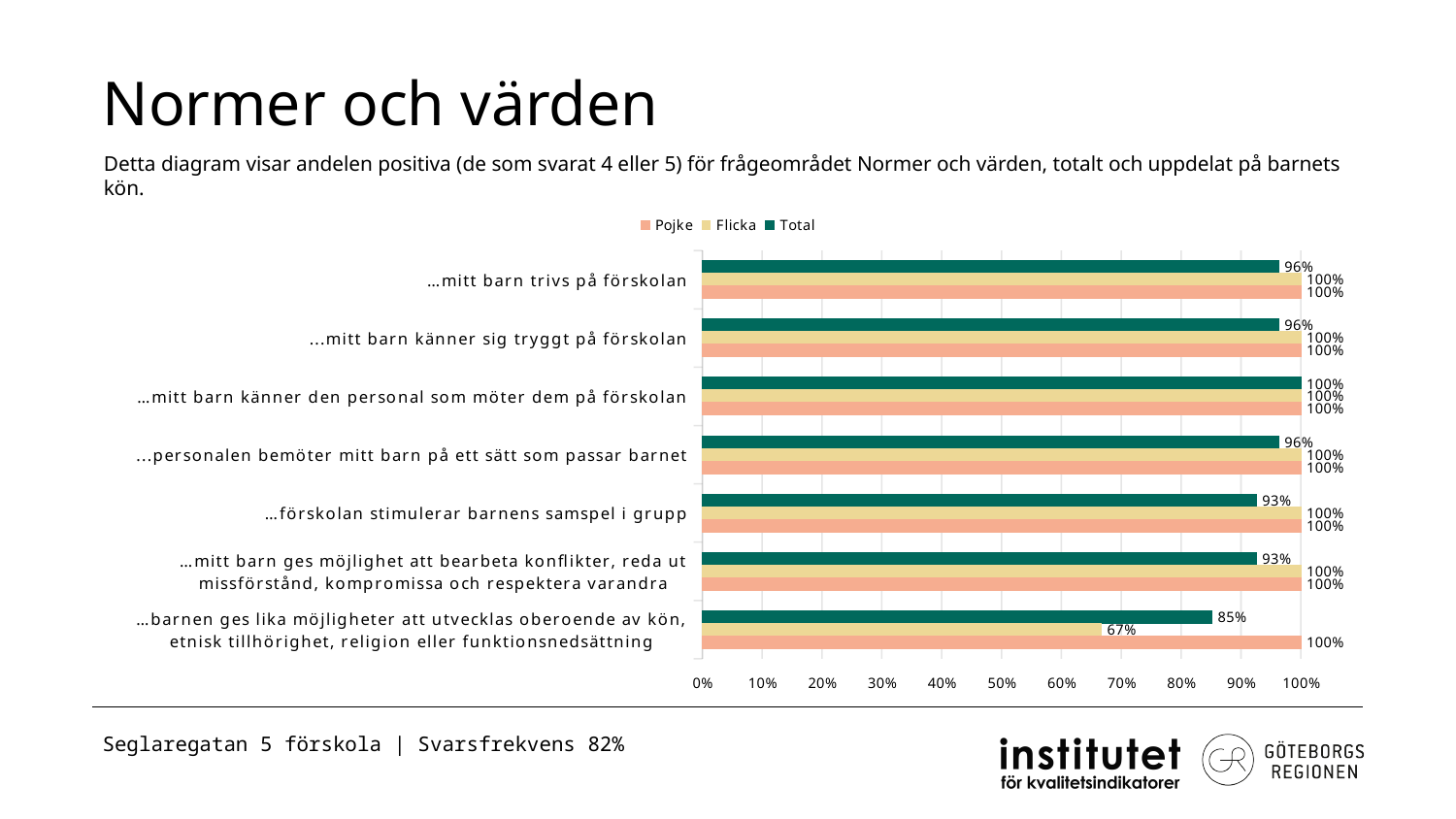
What type of chart is shown on the slide? bar chart How many series does the legend list? 3 What is the Total value for "…förskolan stimulerar barnens samspel i grupp"? 93% What is the Total value for "…mitt barn trivs på förskolan"? 96% Which statement has the lowest Flicka value? …barnen ges lika möjligheter att utvecklas oberoende av kön, etnisk tillhörighet, religion eller funktionsnedsättning For "…mitt barn känner sig tryggt på förskolan", which is larger: the Total value or the Flicka value? Flicka Which series is shown in green in the legend? Total What is the difference between the Pojke and Flicka values for "…barnen ges lika möjligheter att utvecklas oberoende av kön, etnisk tillhörighet, religion eller funktionsnedsättning"? 33% What is the Flicka value for "…barnen ges lika möjligheter att utvecklas oberoende av kön, etnisk tillhörighet, religion eller funktionsnedsättning"? 67% How many categories (statements) are shown on the chart? 7 Which statement has the lowest Total value? …barnen ges lika möjligheter att utvecklas oberoende av kön, etnisk tillhörighet, religion eller funktionsnedsättning What is the Pojke value for "…barnen ges lika möjligheter att utvecklas oberoende av kön, etnisk tillhörighet, religion eller funktionsnedsättning"? 100%